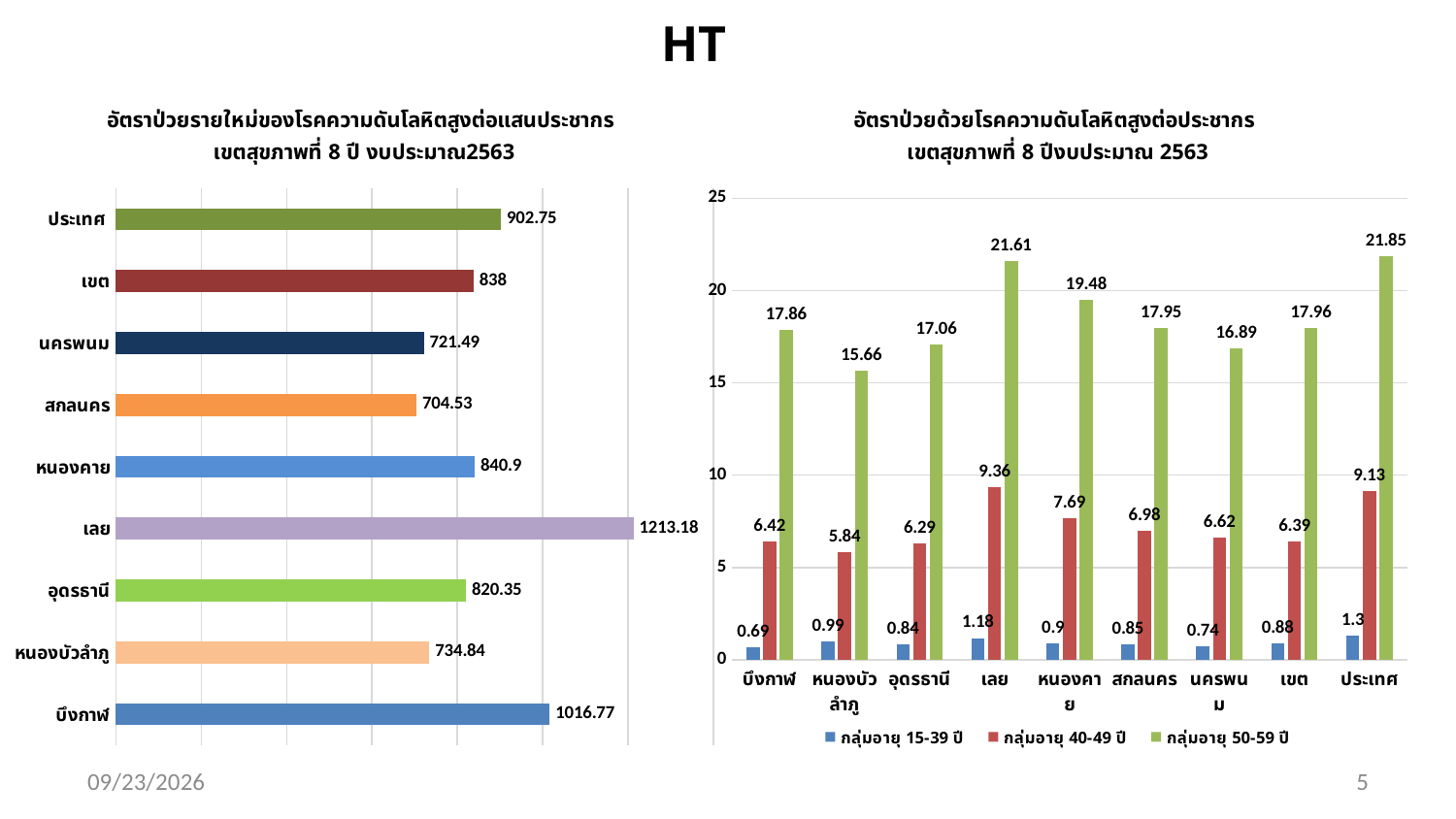
In the left chart, which category has the lowest value? สกลนคร In the left chart, which category has the highest value? เลย In the right chart, which category has the lowest value in the กลุ่มอายุ 40-49 ปี series? หนองบัวลำภู In the left chart, how many categories are shown? 9 In the right chart, which category has the highest value in the กลุ่มอายุ 50-59 ปี series? ประเทศ In the left chart, what is the difference between the values for บึงกาฬ and ประเทศ? 114.02 In the right chart, what is the value for เลย in the กลุ่มอายุ 50-59 ปี series? 21.61 In the right chart, which is larger for the กลุ่มอายุ 40-49 ปี series: เลย or หนองคาย? เลย What kind of chart is the left chart? Bar chart In the left chart, what is the value for เลย? 1213.18 In the right chart, how many series does the legend list? 3 In the right chart, what is the difference between the กลุ่มอายุ 50-59 ปี values for ประเทศ and เขต? 3.89